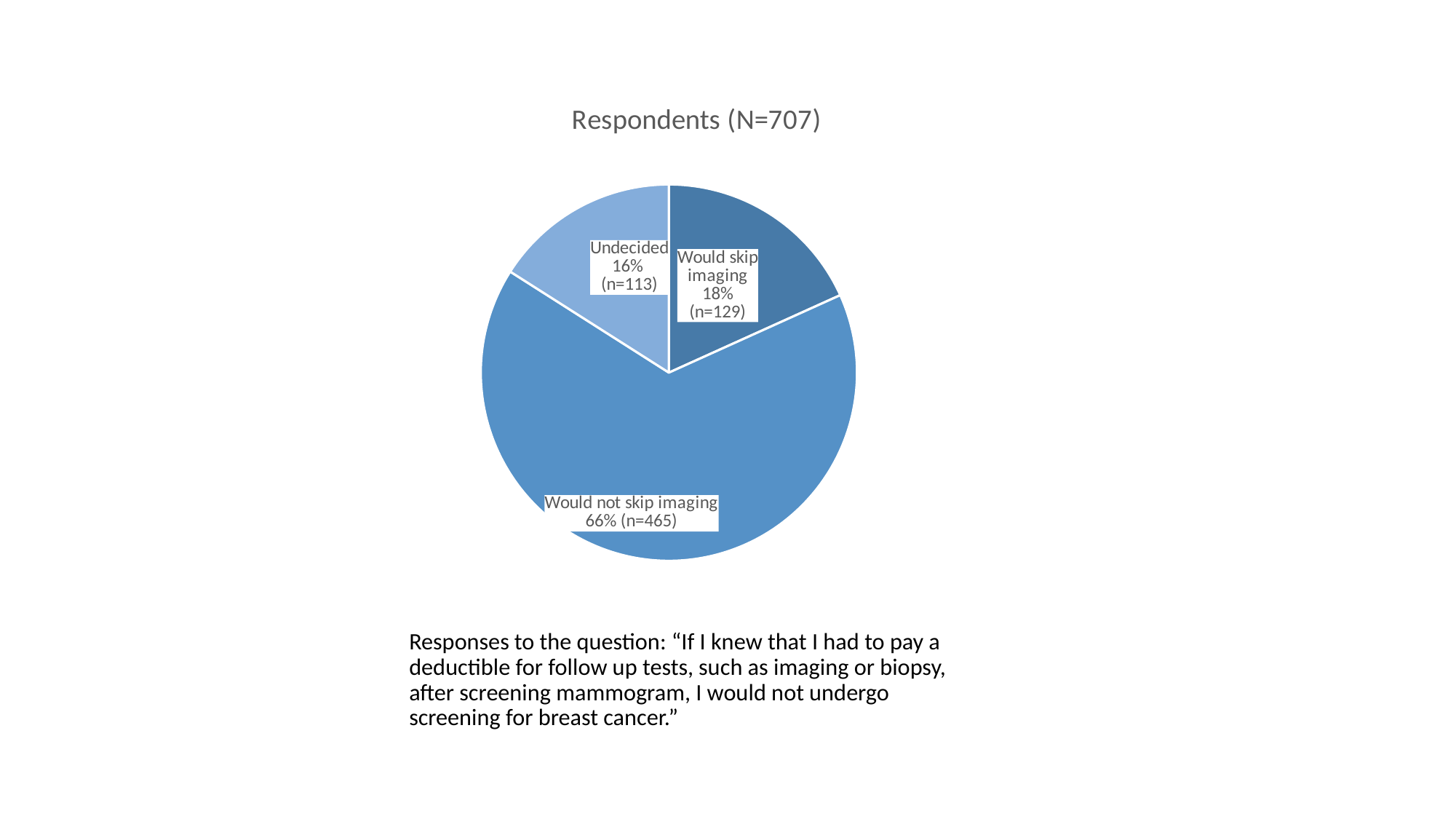
What percentage of respondents would not skip imaging? 66% What kind of chart is shown on the slide? pie chart Which response category has the largest share of the pie? Would not skip imaging How many slices does the pie chart have? 3 How many respondents said they would skip imaging? 129 How many respondents said they would not skip imaging? 465 What percentage of respondents were undecided? 16% What is the title of the chart? Respondents (N=707) Which response category has the smallest share of the pie? Undecided What percentage of respondents would skip imaging? 18% What is the difference in percentage points between 'Would skip imaging' and 'Undecided'? 2 How many respondents were undecided? 113